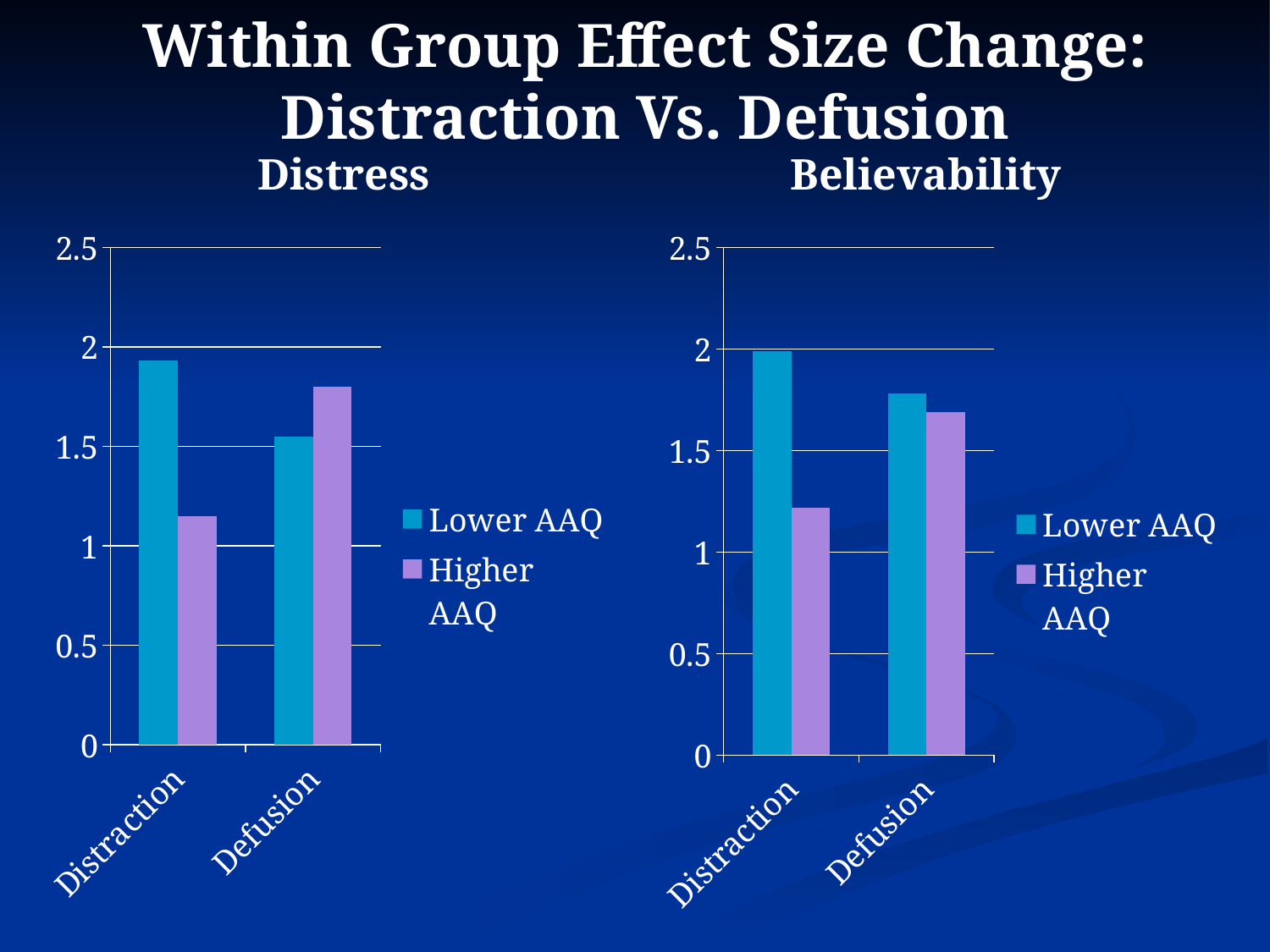
In the Believability chart, which bar is the highest? Lower AAQ for Distraction In the Distress chart, which is larger for Defusion: Lower AAQ or Higher AAQ? Higher AAQ In the Distress chart, is the Lower AAQ value for Distraction greater or less than 1.5? greater In the Believability chart, is the Lower AAQ value for Distraction greater or less than 1.5? greater In the Distress chart, which is larger for Distraction: Lower AAQ or Higher AAQ? Lower AAQ In the Believability chart, is the Higher AAQ value for Distraction greater or less than 1.5? less What colour represents the Higher AAQ series in the Distress chart? purple How many series does the legend of the Believability chart list? 2 How many categories are shown on the x axis of the Distress chart? 2 In the Believability chart, which bar is the lowest? Higher AAQ for Distraction What kind of chart is the Distress chart? bar chart